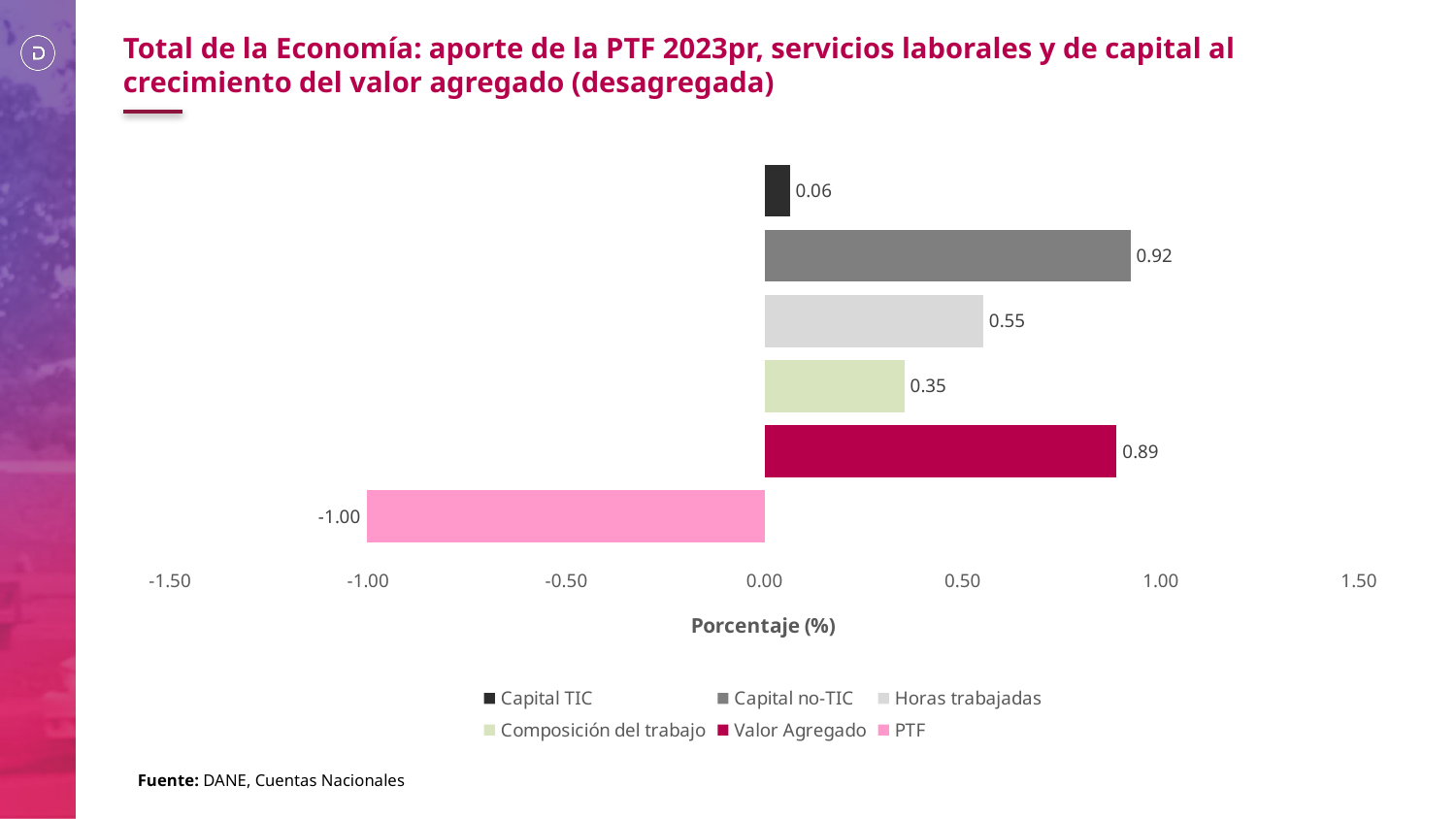
What is the label of the horizontal axis? Porcentaje (%) How many series does the legend list? 6 What is the value shown for Capital TIC? 0.06 What is the value shown for Composición del trabajo? 0.35 Which series has the highest value in the chart? Capital no-TIC What is the value shown for Capital no-TIC? 0.92 What kind of chart is shown on the slide? Bar chart What is the value shown for PTF? -1.00 What is the value shown for Horas trabajadas? 0.55 What is the difference between the values for Capital no-TIC and Valor Agregado? 0.03 Which is larger, the value for Horas trabajadas or the value for Composición del trabajo? Horas trabajadas Which series has the lowest value in the chart? PTF